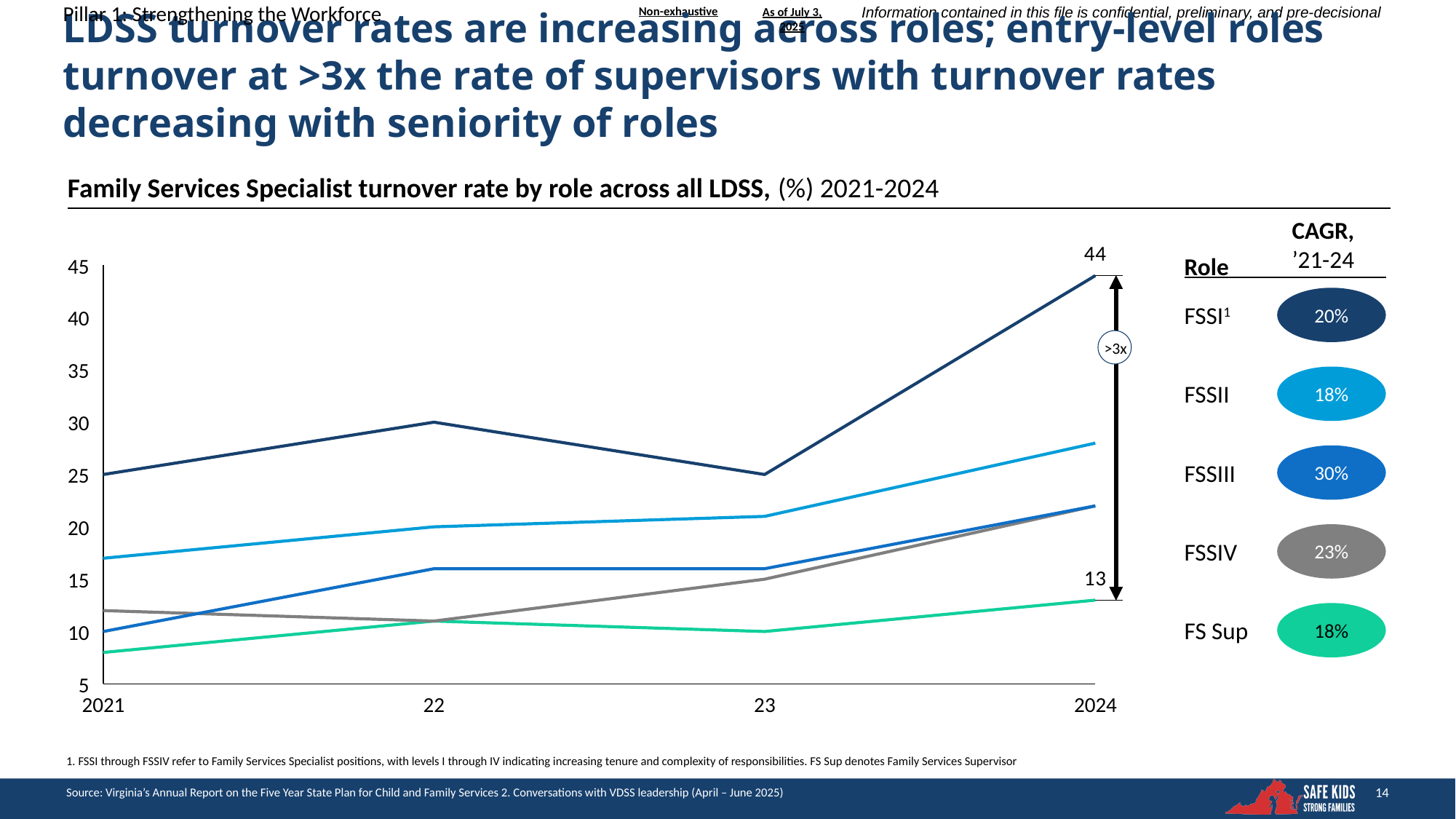
How many years are plotted along the x axis of the chart? 4 How many roles (series) are listed in the legend on the right of the chart? 5 Is the turnover rate for FSSI in 2021 greater or less than 20? greater Which role has the highest turnover rate in 2024? FSSI What is the difference between the FSSI and FS Sup turnover rates in 2024? 31 What is the turnover rate for FS Sup in 2024? 13 Which role has the lowest turnover rate in 2024? FS Sup What is the turnover rate for FSSI in 2024? 44 What kind of chart is shown on the slide? line chart Which is larger, the FSSI turnover rate in 2022 or in 2023? 2022 What is the CAGR '21-24 shown for FSSIII? 30% Is the turnover rate for FSSIV in 2021 greater or less than 15? less